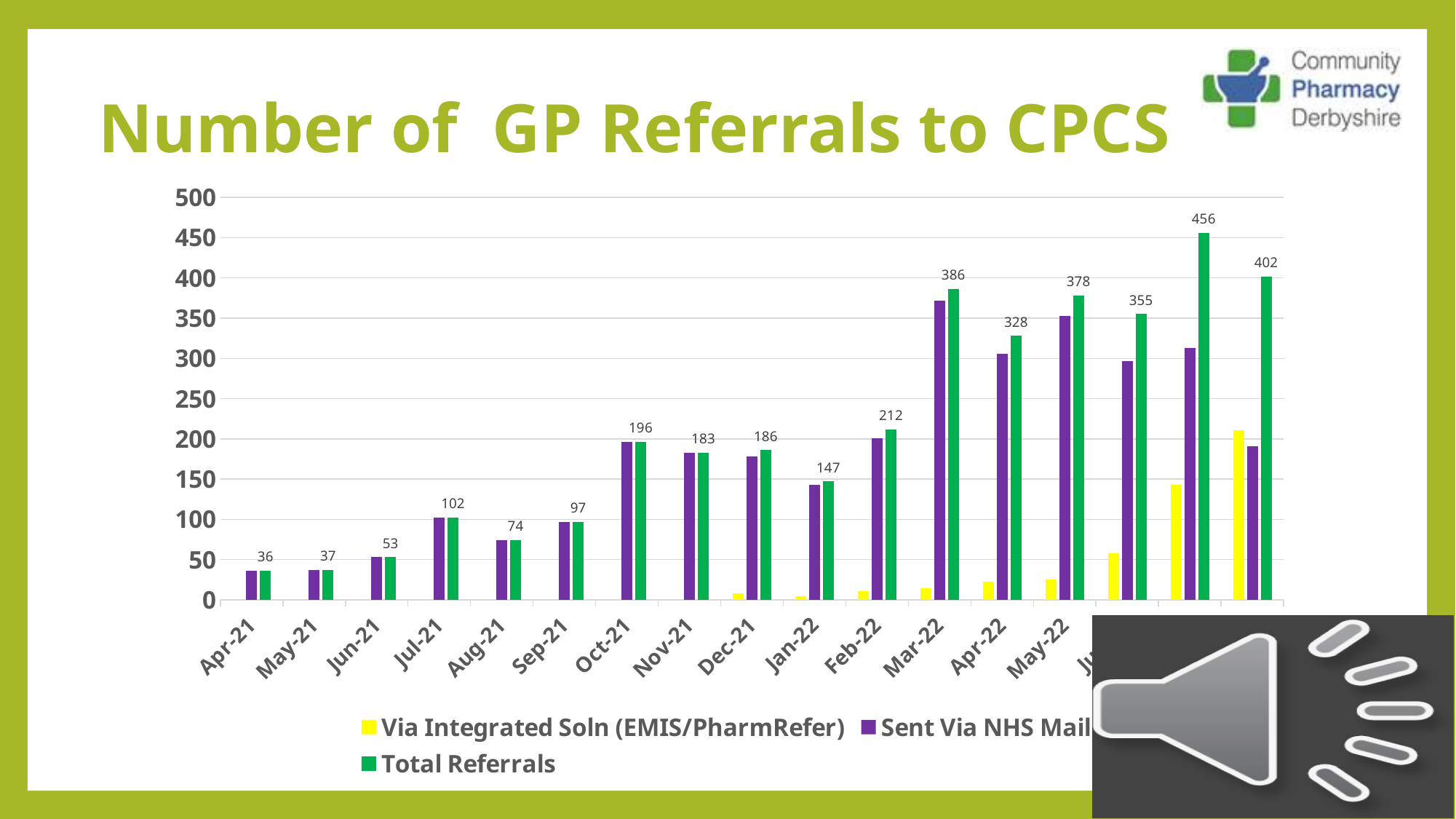
Which month has the lowest Total Referrals? Apr-21 How many series does the legend list? 3 Is the Sent Via NHS Mail value for Mar-22 greater or less than 350? greater What is the highest Total Referrals value labelled on the chart? 456 What is the difference in Total Referrals between Jul-21 and Aug-21? 28 Do Total Referrals rise or fall from Apr-21 to Jul-21? rise What kind of chart is shown on the slide? bar chart What is the Total Referrals value for Mar-22? 386 What is the Total Referrals value for Feb-22? 212 What is the Total Referrals value for Apr-21? 36 What is the difference in Total Referrals between Mar-22 and Feb-22? 174 Which month has higher Total Referrals, Oct-21 or Nov-21? Oct-21